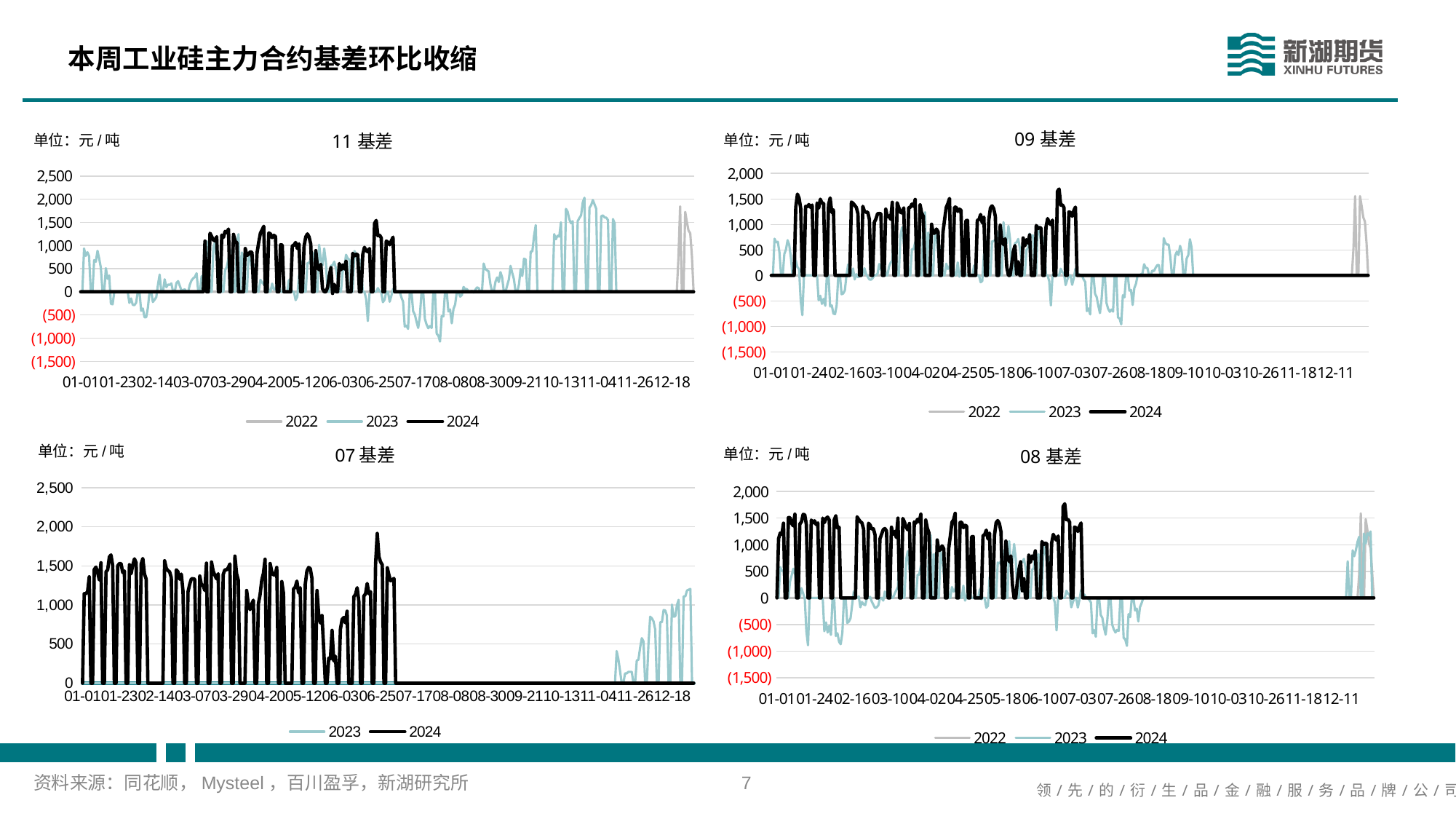
In the "11 基差" chart, is the highest value of the 2023 series greater or less than 1,500? greater In the "07 基差" chart, is the highest value of the 2024 series greater or less than 1,500? greater How many series does the legend of the "09 基差" chart list? 3 How many series does the legend of the "07 基差" chart list? 2 In the "09 基差" chart, is the lowest value of the 2023 series greater or less than 0? less In the "07 基差" chart, which series reaches a higher peak, 2023 or 2024? 2024 What is the unit shown for the "08 基差" chart? 元 / 吨 In the "11 基差" chart, which series reaches a higher peak, 2023 or 2024? 2023 Which series is drawn with the thick black line in the "09 基差" chart? 2024 What kind of chart is the "11 基差" chart? line chart